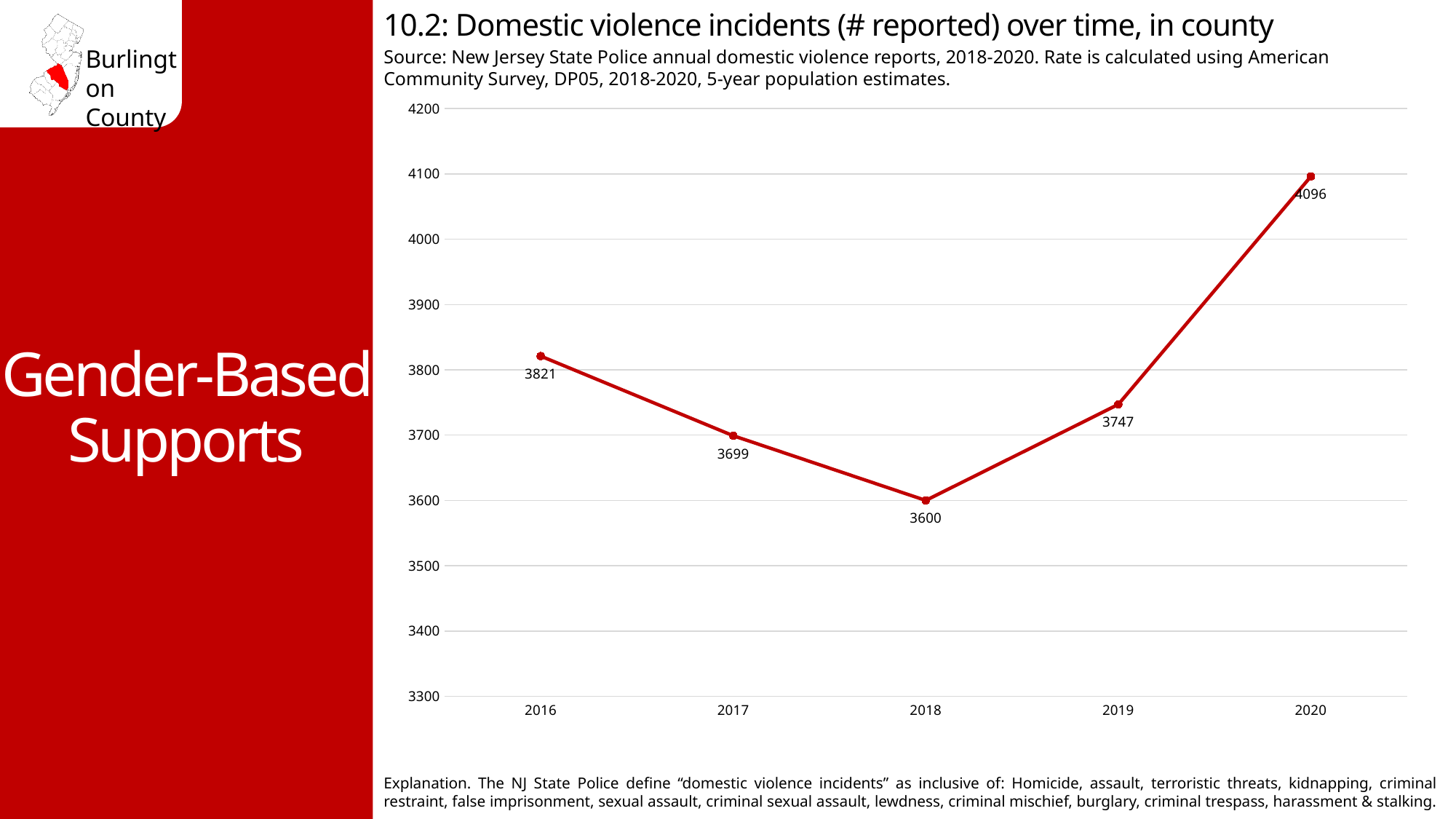
What was the number of reported domestic violence incidents in 2018? 3600 How many more incidents were reported in 2020 than in 2019? 349 What was the number of reported domestic violence incidents in 2020? 4096 Is the value for 2019 greater or less than 3800? less What kind of chart is shown on the slide? Line chart What is the difference between the 2016 and 2017 values? 122 Which year had the lowest number of reported domestic violence incidents? 2018 How many years are plotted on the chart? 5 Which year had the highest number of reported domestic violence incidents? 2020 Did the number of reported incidents rise or fall from 2018 to 2020? Rise What was the number of reported domestic violence incidents in 2016? 3821 Which year had more reported incidents, 2017 or 2019? 2019